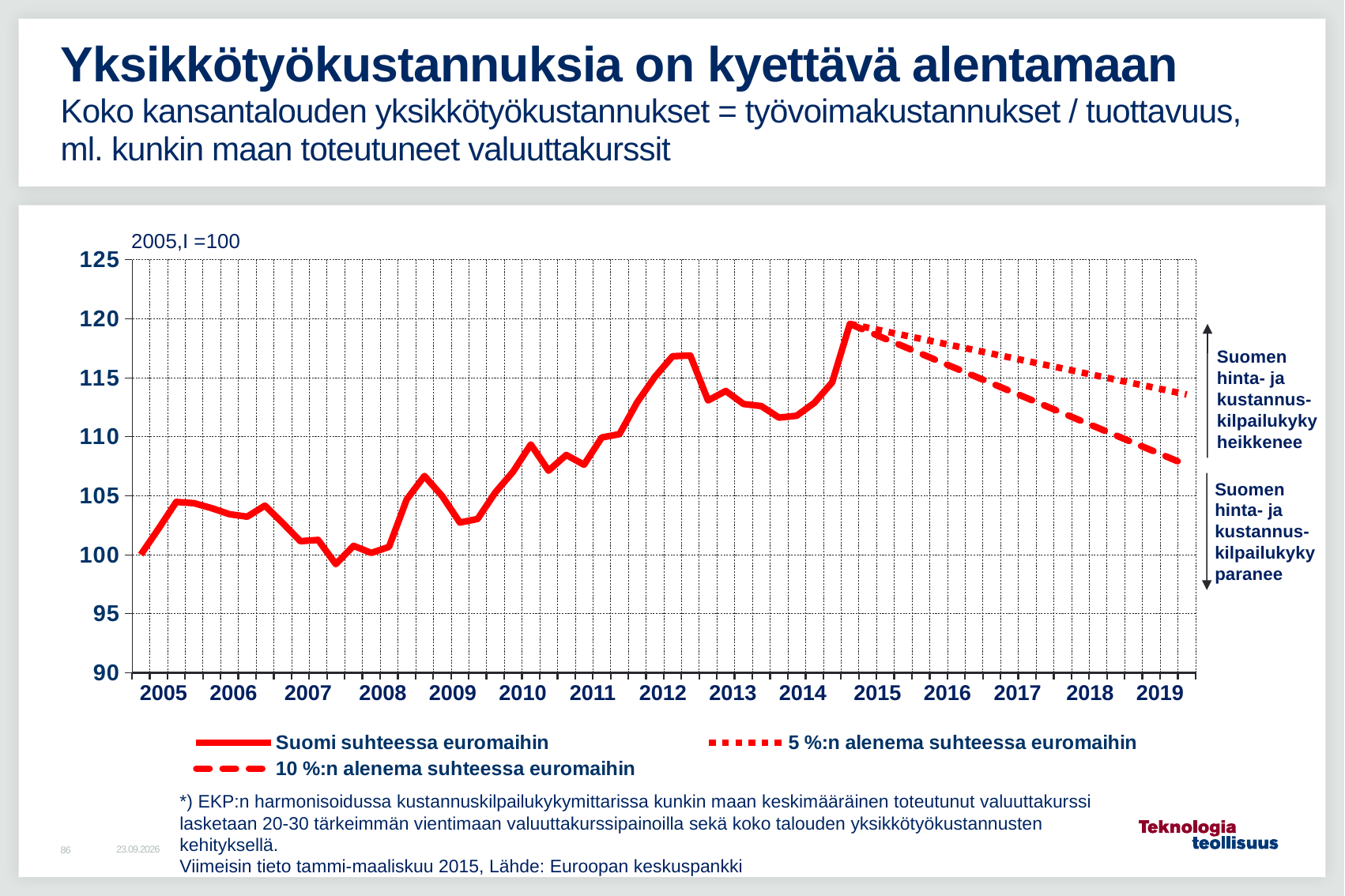
Is the value of the '10 %:n alenema suhteessa euromaihin' series at the end of 2019 greater or less than 110? less Does the 'Suomi suhteessa euromaihin' series overall rise or fall from 2005 to 2015? rise What base period and value is stated above the chart? 2005,I =100 Is the value of the 'Suomi suhteessa euromaihin' series in 2007 greater or less than 105? less Is the value of the 'Suomi suhteessa euromaihin' series at the start of 2015 greater or less than 115? greater At the end of 2019, which series is higher: '5 %:n alenema suhteessa euromaihin' or '10 %:n alenema suhteessa euromaihin'? 5 %:n alenema suhteessa euromaihin What is the index value of the 'Suomi suhteessa euromaihin' series at the start of 2005? 100 Does the '10 %:n alenema suhteessa euromaihin' series rise or fall from 2015 to 2019? fall What kind of chart is shown on the slide? line chart How many year labels are shown on the x axis? 15 How many series does the legend list? 3